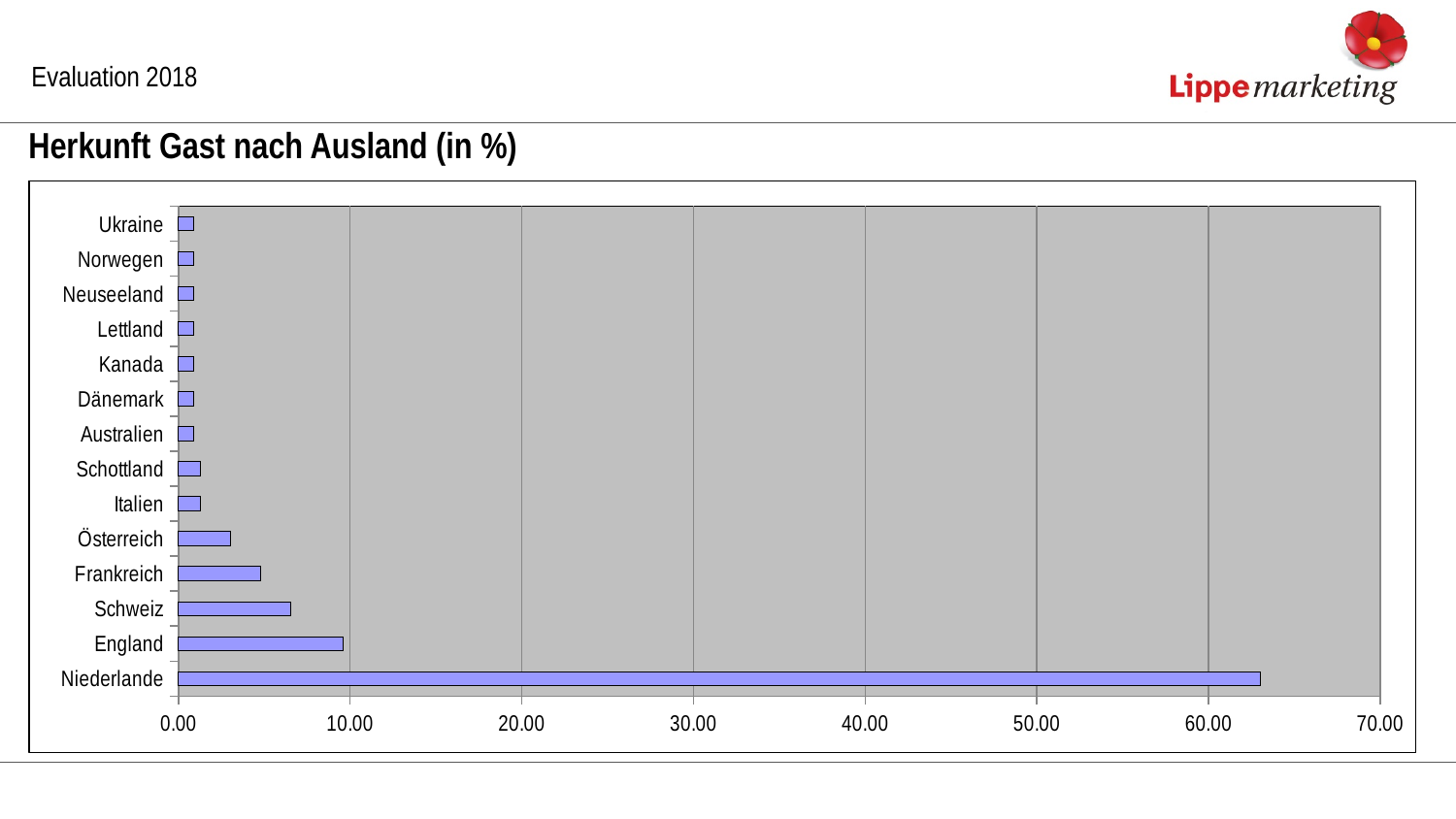
Is the value for Schweiz greater or less than 10.00? less Is the value for Niederlande greater or less than 60.00? greater What kind of chart is shown on the slide? bar chart Which has the larger value, England or Schweiz? England What is the highest value shown on the horizontal axis? 70.00 Which has the larger value, Frankreich or Österreich? Frankreich Which has the larger value, Schweiz or Frankreich? Schweiz Is the value for England greater or less than 10.00? less Which country has the highest value? Niederlande How many countries are listed on the chart? 14 What is the title of the chart? Herkunft Gast nach Ausland (in %)